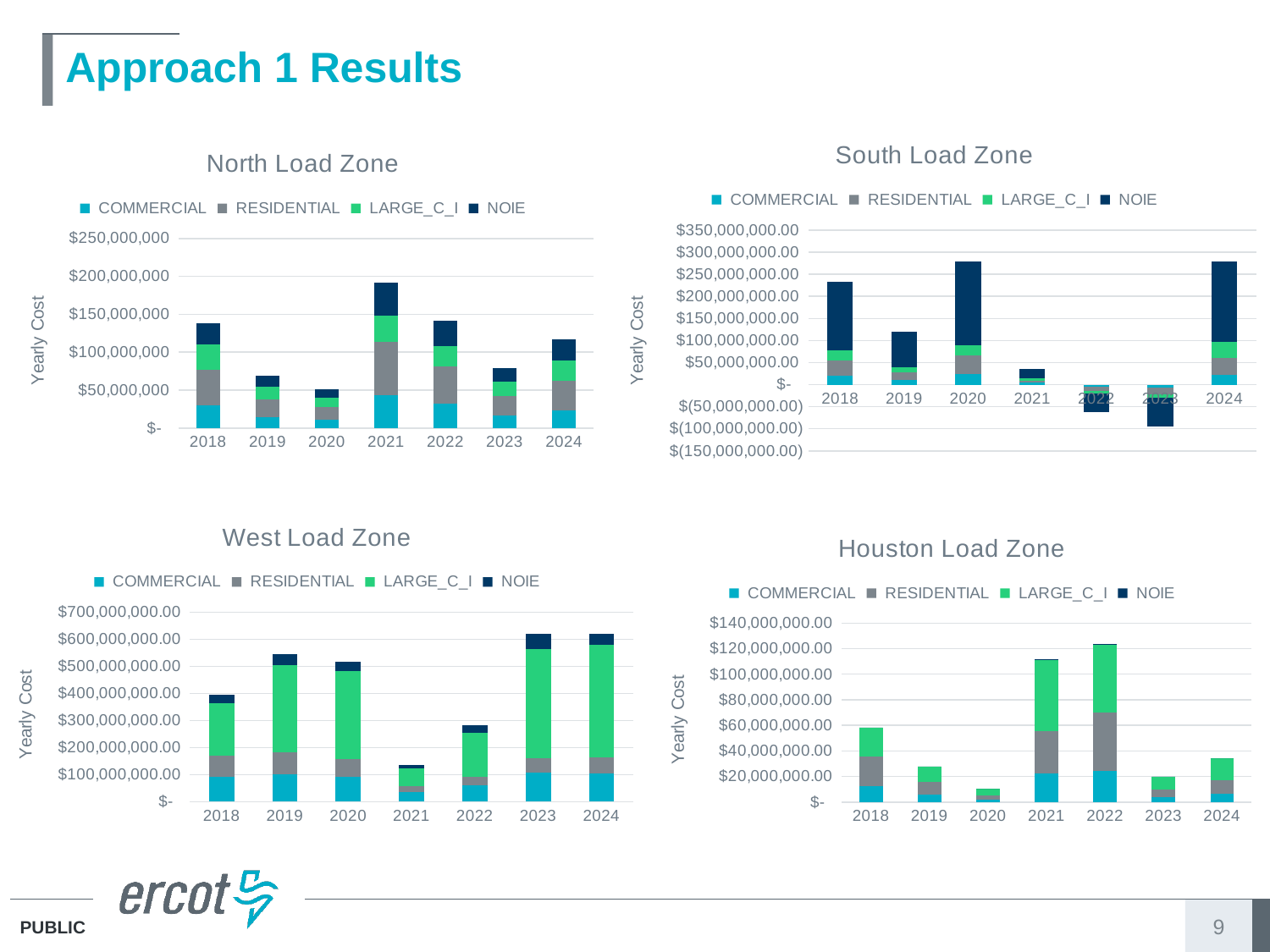
What is the y-axis label on the South Load Zone chart? Yearly Cost How many years are shown on the x axis of the Houston Load Zone chart? 7 In the North Load Zone chart, which year has the highest total yearly cost? 2021 In the West Load Zone chart, which year has the lowest total yearly cost? 2021 In the West Load Zone chart, is the total for 2019 greater or less than $500,000,000.00? greater In the Houston Load Zone chart, which year has the highest total yearly cost? 2022 In the South Load Zone chart, is the total for 2018 greater or less than $200,000,000.00? greater In the Houston Load Zone chart, is the total for 2020 greater or less than $20,000,000.00? less In the North Load Zone chart, which year has the lowest total yearly cost? 2020 What kind of chart is the North Load Zone chart? stacked bar chart How many series does the legend of the West Load Zone chart list? 4